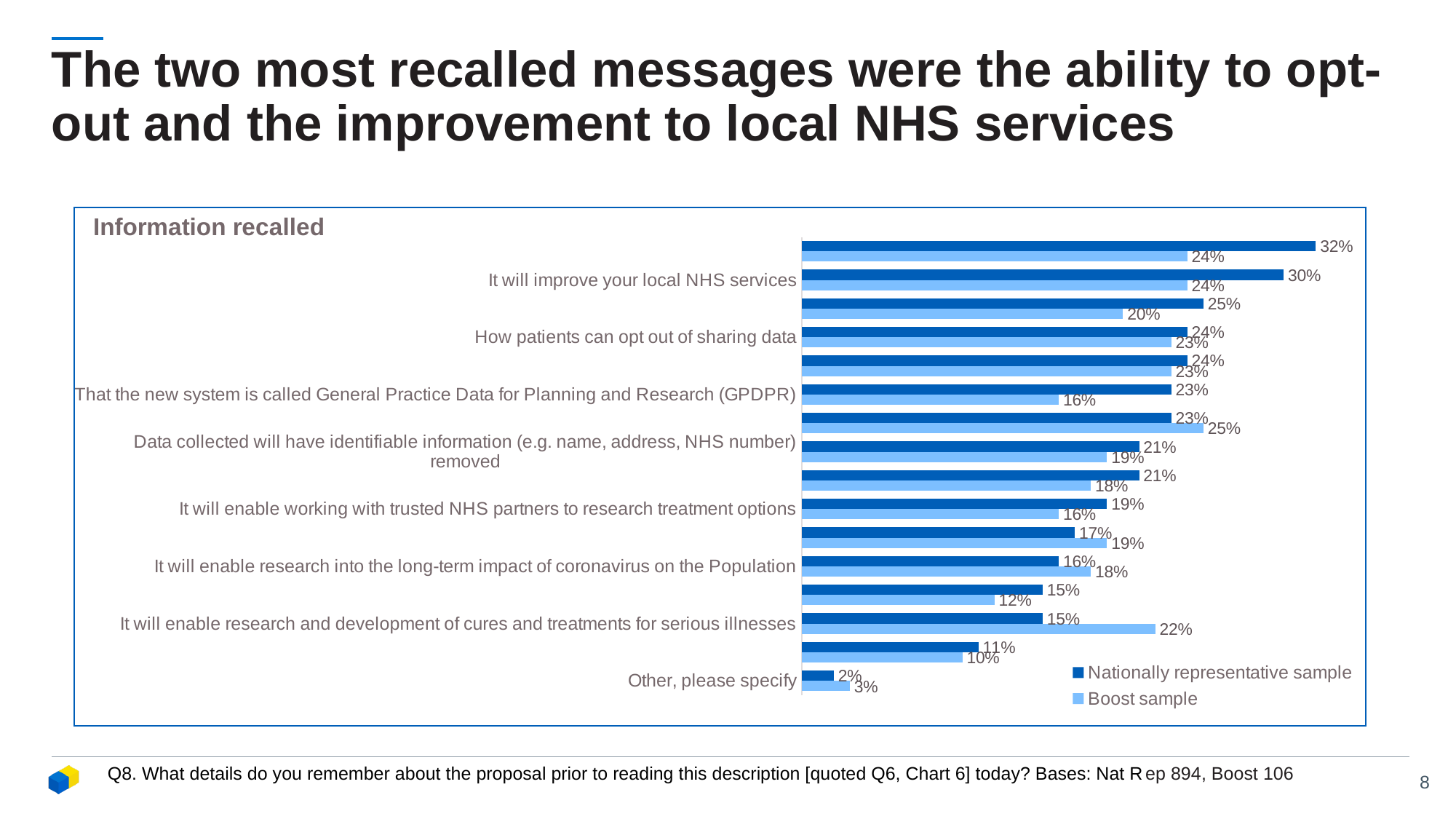
What is the title of the chart on the slide? Information recalled What is the Boost sample value for 'It will improve your local NHS services'? 24% What type of chart is shown on the slide? bar chart For 'It will improve your local NHS services', which is larger: the Nationally representative sample or the Boost sample value? Nationally representative sample What is the difference between the Nationally representative sample and Boost sample values for 'It will improve your local NHS services'? 6% What is the highest Nationally representative sample value shown in the chart? 32% Which category has the lowest Nationally representative sample value? Other, please specify What is the Nationally representative sample value for 'It will improve your local NHS services'? 30% What are the two series named in the legend of the 'Information recalled' chart? Nationally representative sample; Boost sample What is the Boost sample value for 'Other, please specify'? 3% What is the Nationally representative sample value for 'Other, please specify'? 2% How many series does the legend list in the 'Information recalled' chart? 2